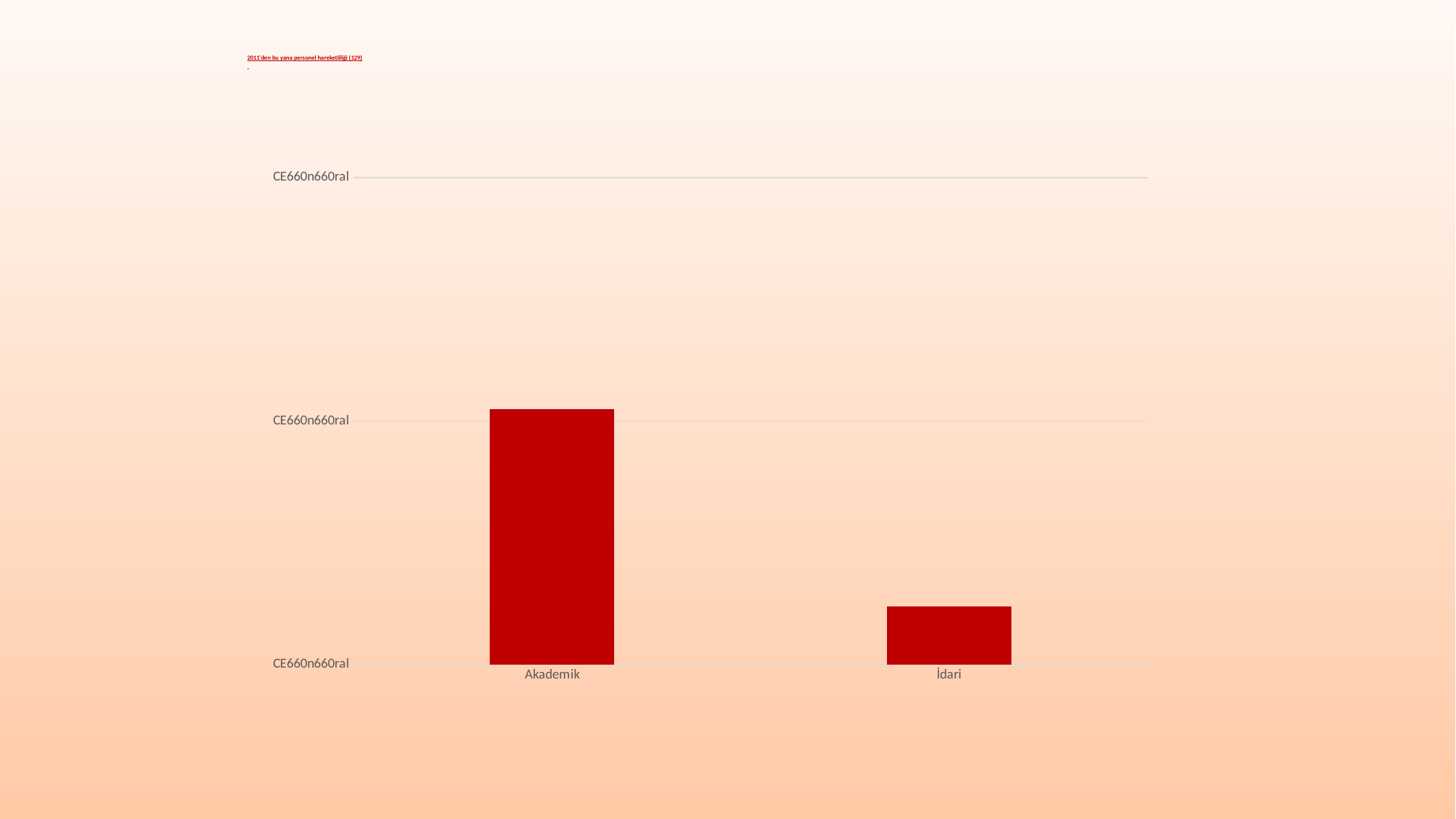
Which category has the lowest bar in the chart? İdari Which category has the highest bar in the chart? Akademik How many categories are shown on the x axis of the chart? 2 What colour are the bars in the chart? red What kind of chart is shown on the slide? bar chart Which is larger, the value for Akademik or the value for İdari? Akademik What are the two category labels on the x axis of the chart? Akademik and İdari